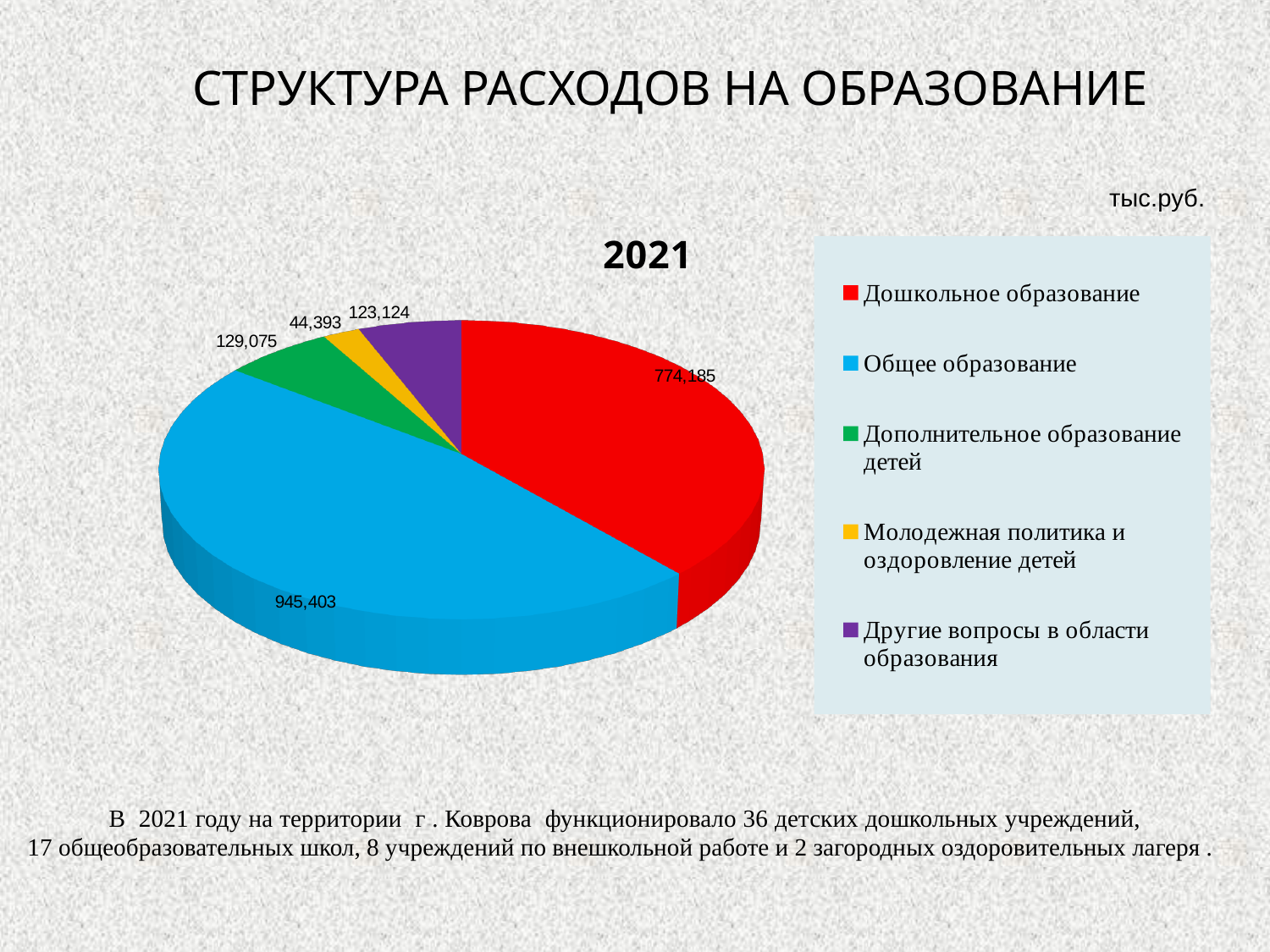
What is the value for Молодежная политика и оздоровление детей? 44,393 What is the value for Дополнительное образование детей? 129,075 What colour is the slice for Дошкольное образование? red How many categories does the pie chart have? 5 What is the value for Общее образование in the 2021 pie chart? 945,403 What type of chart is shown on the slide? pie chart Which category has the smallest slice of the pie? Молодежная политика и оздоровление детей What is the value for Другие вопросы в области образования? 123,124 What is the value for Дошкольное образование in the 2021 pie chart? 774,185 Which category has the largest slice of the pie? Общее образование Which is larger: Дополнительное образование детей or Другие вопросы в области образования? Дополнительное образование детей What is the difference between the values for Общее образование and Дошкольное образование? 171,218